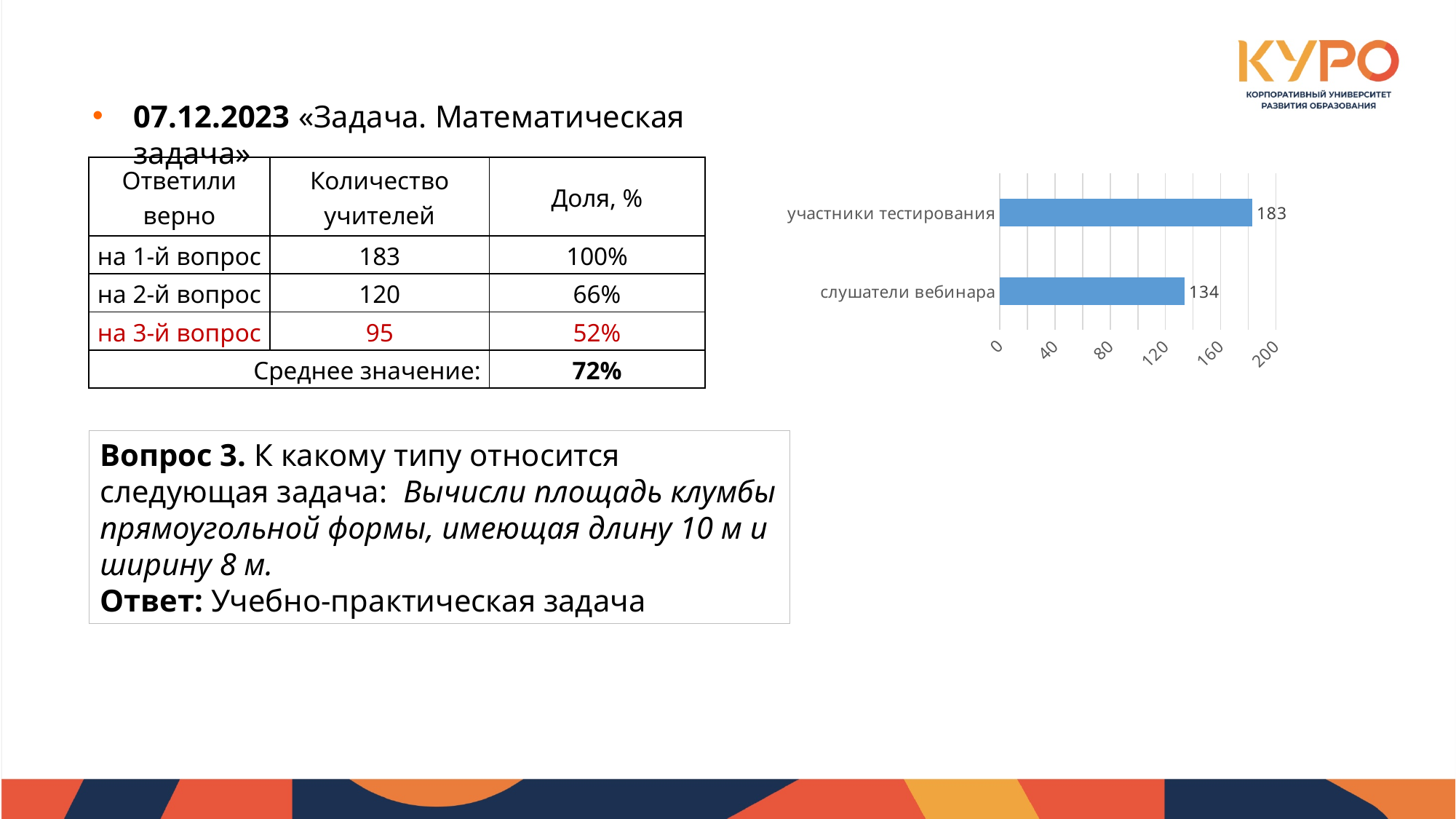
Is the value for участники тестирования greater or less than 200? less Which category has the lowest value in the bar chart? слушатели вебинара Which is larger in the bar chart: участники тестирования or слушатели вебинара? участники тестирования What is the value for слушатели вебинара in the bar chart? 134 Is the value for слушатели вебинара greater or less than 120? greater What colour are the bars in the chart? blue What kind of chart is shown on the slide? bar chart What is the value for участники тестирования in the bar chart? 183 What is the difference between the values for участники тестирования and слушатели вебинара in the bar chart? 49 How many categories are shown in the bar chart? 2 Which category has the highest value in the bar chart? участники тестирования What is the maximum value shown on the chart's value axis? 200